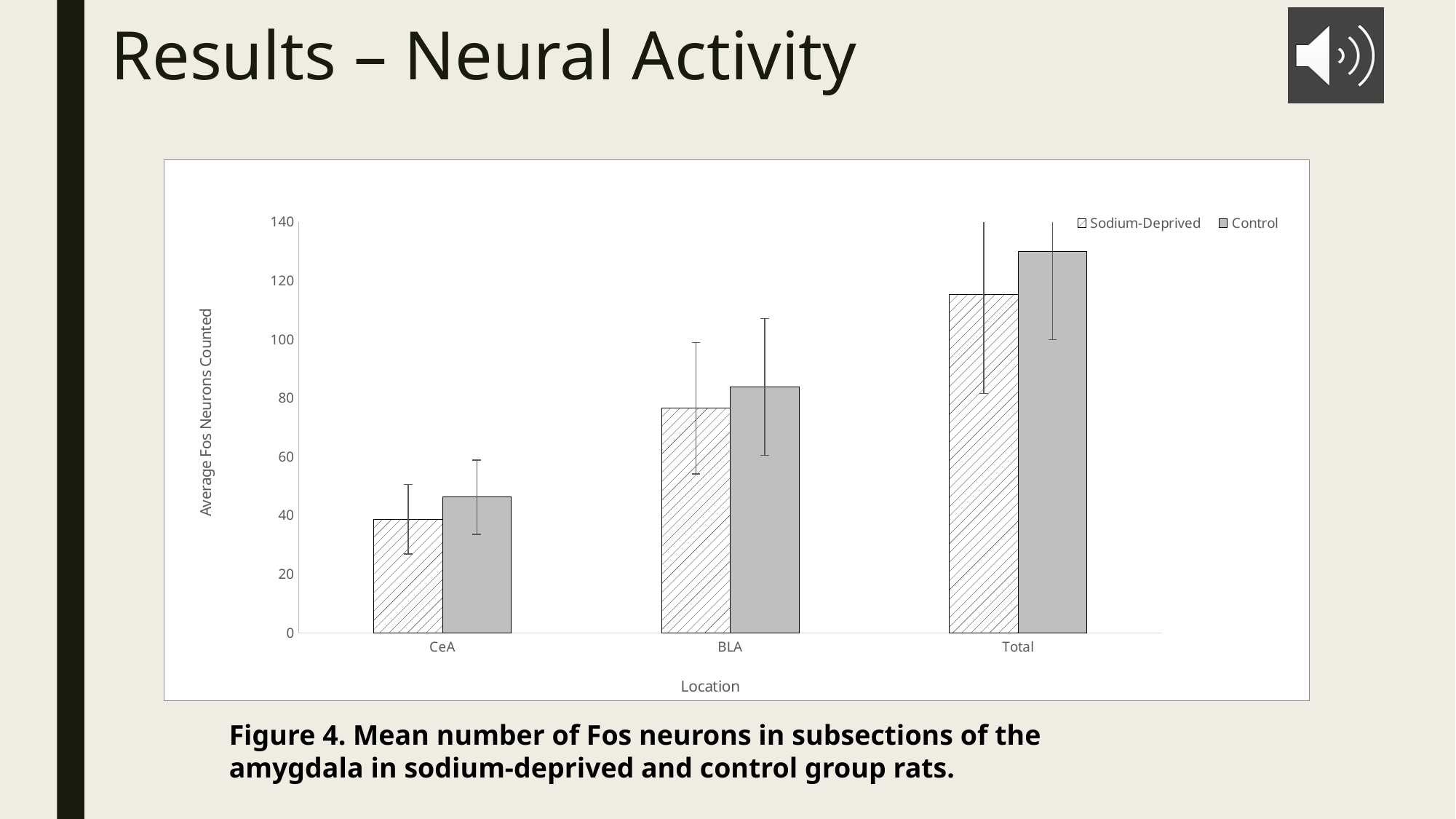
What is the label of the y axis? Average Fos Neurons Counted What kind of chart is shown on the slide? bar chart How many location categories are shown on the x axis? 3 Which location has the lowest Sodium-Deprived value? CeA Do the Sodium-Deprived values rise or fall from CeA to Total along the x axis? rise Is the Control value for BLA greater or less than 80? greater Which location has the highest Control value? Total At BLA, which series has the larger value, Sodium-Deprived or Control? Control Is the Control value for Total greater or less than 120? greater Is the Sodium-Deprived value for Total greater or less than 100? greater How many series does the legend list? 2